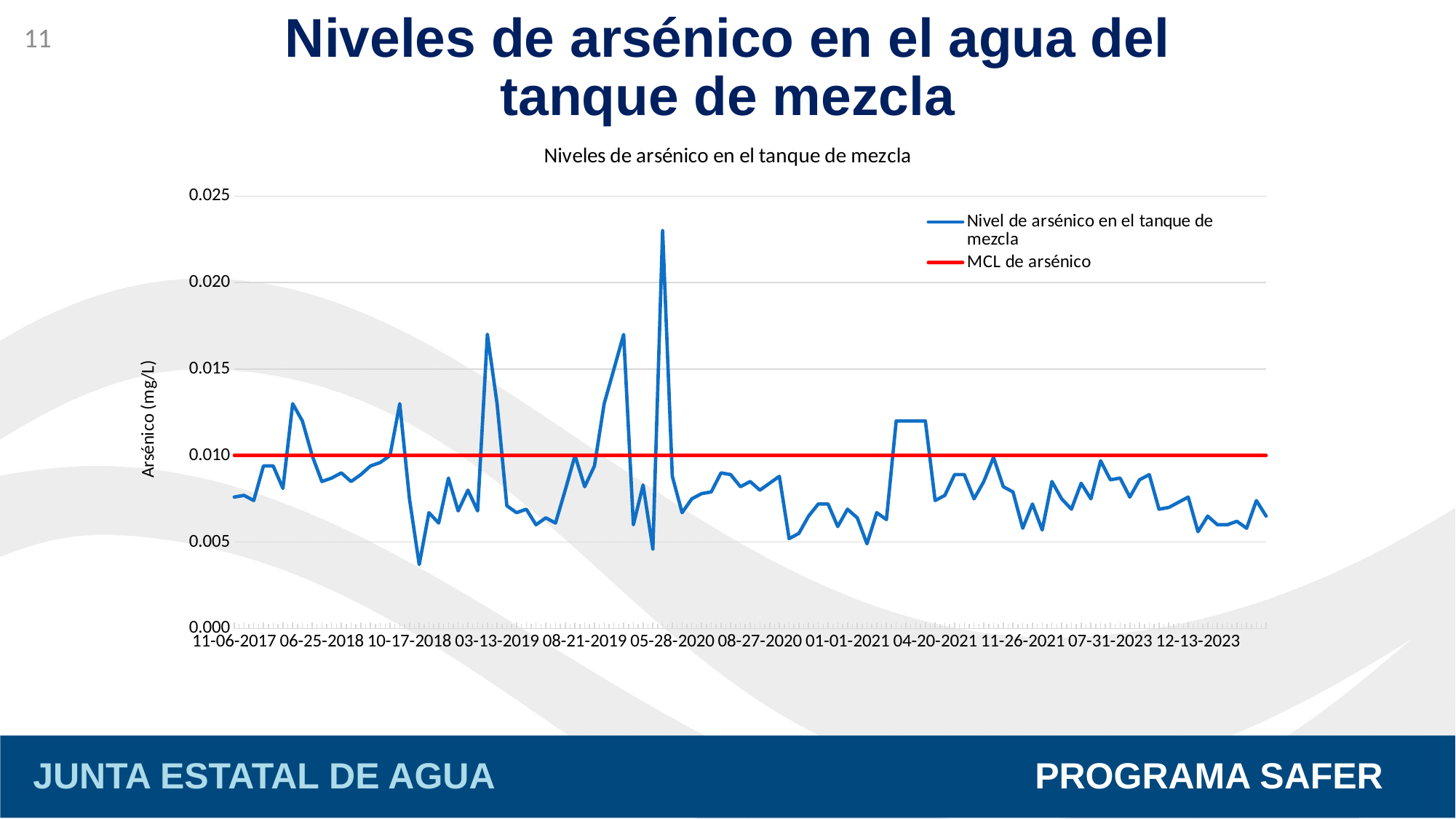
Is the arsenic level at the first point on the left of the chart greater or less than 0.010? less Which is higher: the peak of the arsenic line near 05-28-2020 or the peak near 03-13-2019? The peak near 05-28-2020 Is the lowest point of the 'Nivel de arsénico en el tanque de mezcla' line greater or less than 0.005? less What colour is the line for 'MCL de arsénico'? Red What is the highest value shown on the y axis? 0.025 How many series does the legend list? 2 What kind of chart is shown on the slide? Line chart What is the title of the chart? Niveles de arsénico en el tanque de mezcla Is the highest peak of the 'Nivel de arsénico en el tanque de mezcla' line greater or less than 0.020? greater How many date labels are shown along the x axis? 12 What value does the 'MCL de arsénico' line sit at on the y axis? 0.010